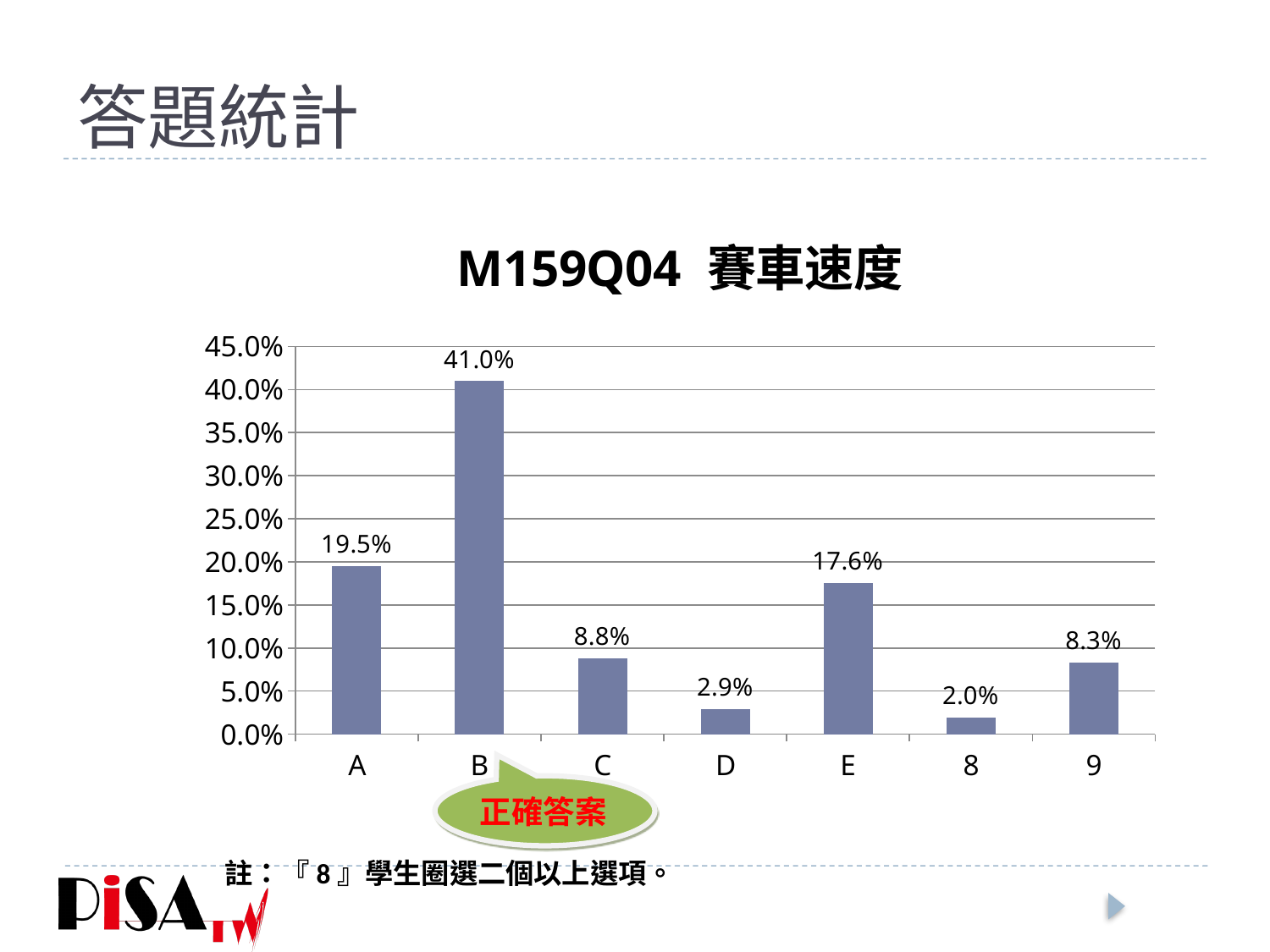
What is the value for category B? 41.0% What kind of chart is shown? bar chart What is the title of the chart? M159Q04 賽車速度 Is the value for D greater or less than 5.0%? less What is the value for category 8? 2.0% How many categories are shown on the x axis? 7 What is the difference between the values for C and 9? 0.5% Which category has the lowest value? 8 What is the value for category E? 17.6% What is the difference between the values for B and A? 21.5% Which is larger, the value for A or the value for E? A Which category has the highest value? B